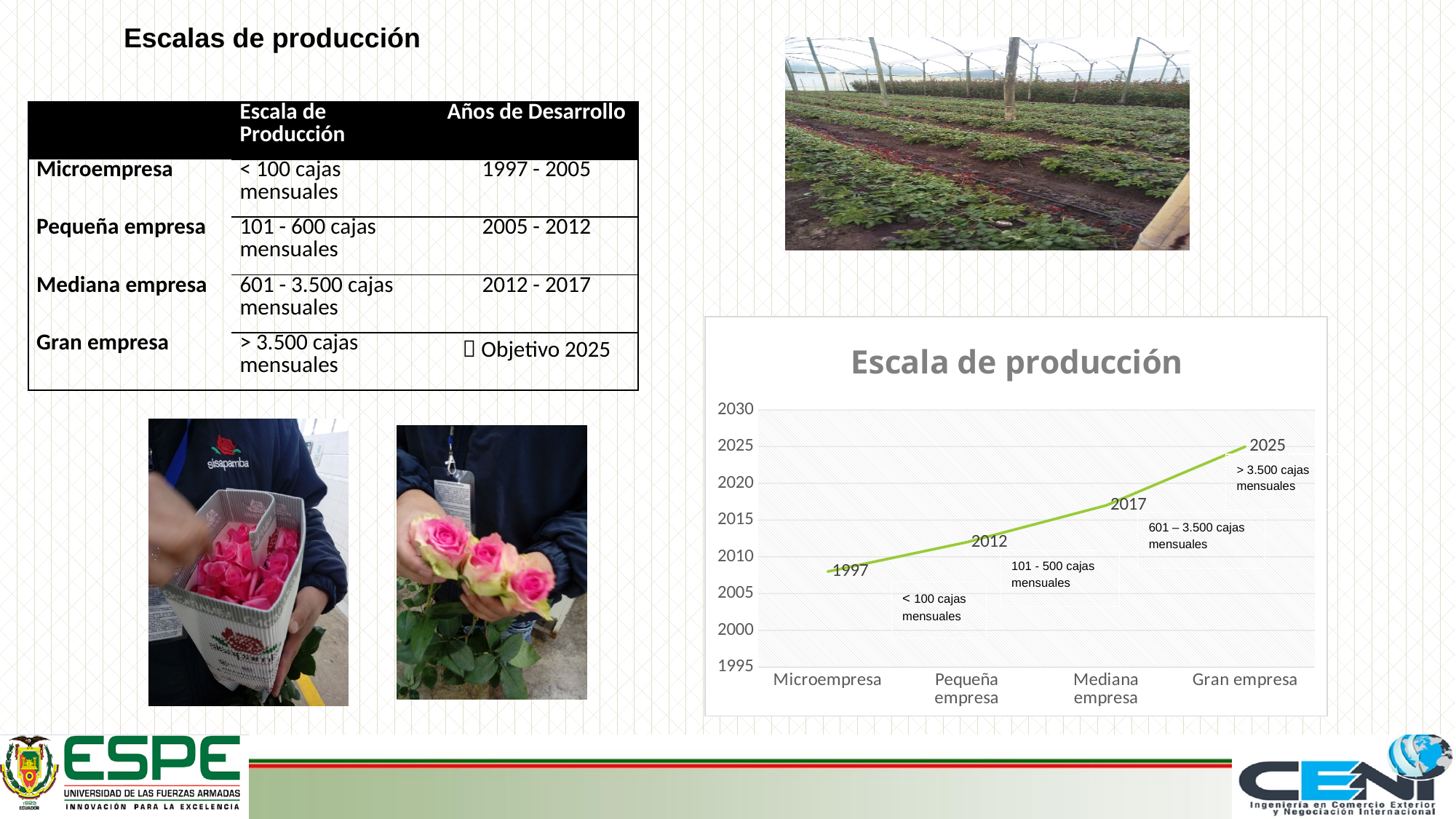
What value is labelled for Microempresa in the chart? 1997 What value is labelled for Pequeña empresa in the chart? 2012 Is the value for Mediana empresa greater or less than 2015? greater What value is labelled for Mediana empresa in the chart? 2017 What is the title of the chart? Escala de producción How many categories are plotted on the x axis of the chart? 4 What value is labelled for Gran empresa in the chart? 2025 Which category has the lowest value in the chart? Microempresa What type of chart is shown on the slide? line chart Which category has the highest value in the chart? Gran empresa Do the values in the chart rise or fall from Microempresa to Gran empresa? rise